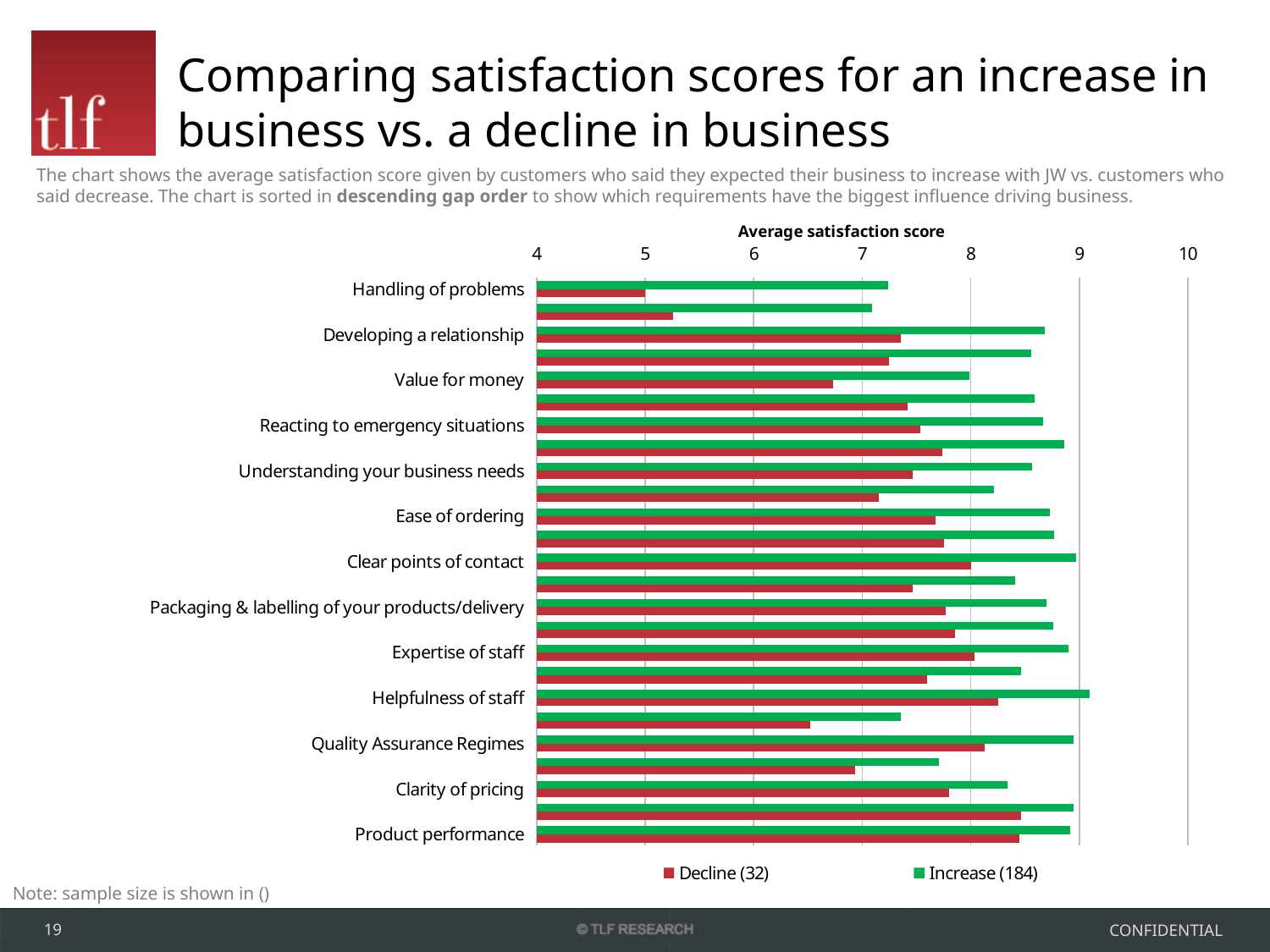
Is the Increase (184) value for Clarity of pricing greater or less than 8? greater Is the Increase (184) value for Developing a relationship greater or less than 8? greater Is the Decline (32) value for Clarity of pricing greater or less than 8? less For Handling of problems, which series has the larger value, Decline (32) or Increase (184)? Increase (184) What is the title shown above the chart's axis? Average satisfaction score How many series does the legend list? 2 Which category has the lowest Decline (32) value? Handling of problems What kind of chart is shown on the slide? bar chart What are the two series named in the legend? Decline (32) and Increase (184)